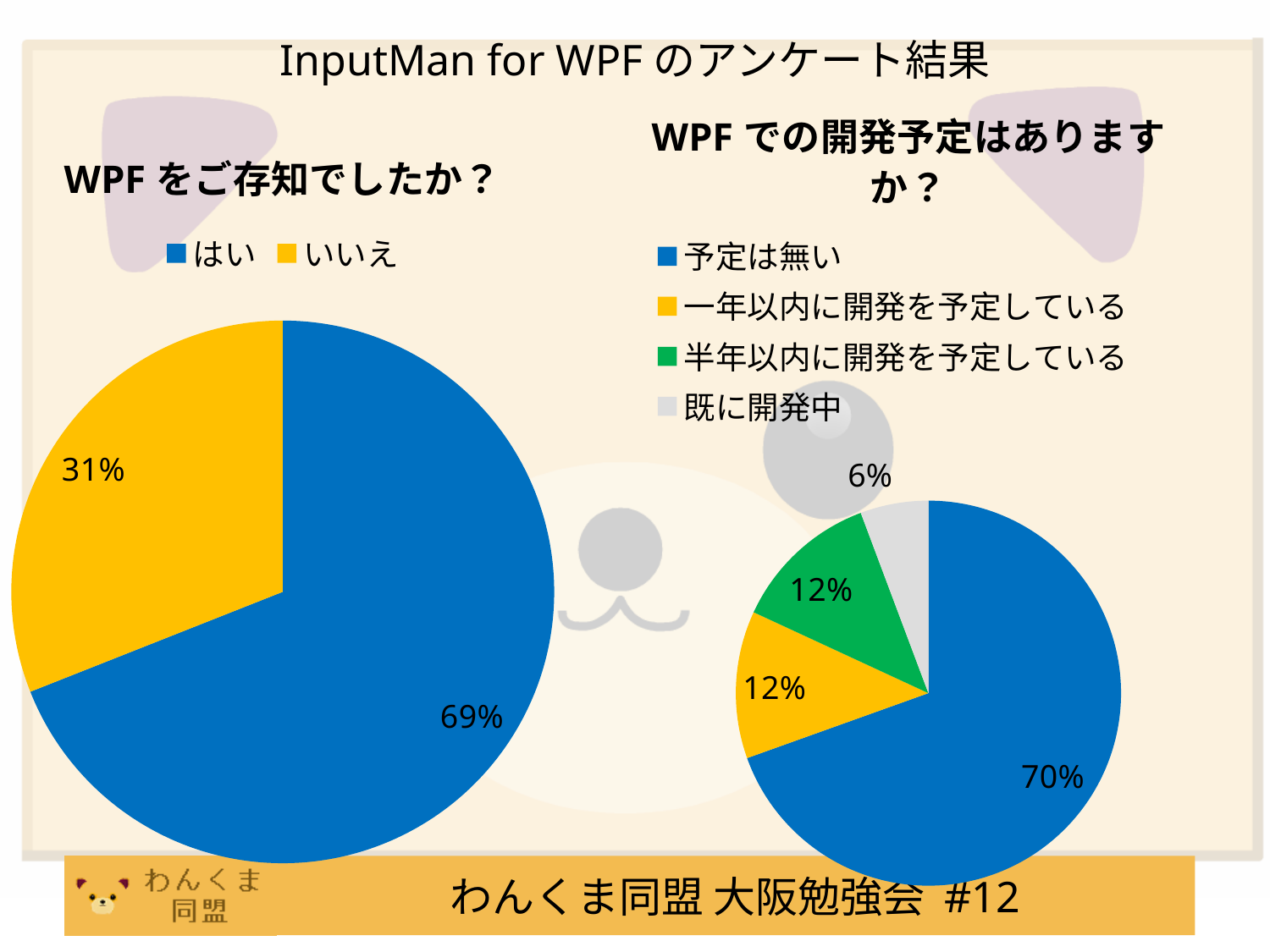
In the chart titled 'WPF での開発予定はありますか？', what share of respondents chose 予定は無い? 70% In the chart titled 'WPF をご存知でしたか？', what share of respondents answered いいえ? 31% How many categories does the legend of the chart titled 'WPF での開発予定はありますか？' list? 4 In the chart titled 'WPF をご存知でしたか？', what share of respondents answered はい? 69% What kind of chart is the one titled 'WPF をご存知でしたか？'? Pie chart In the chart titled 'WPF での開発予定はありますか？', which category has the smallest share? 既に開発中 In the chart titled 'WPF をご存知でしたか？', which answer has the larger share? はい In the chart titled 'WPF での開発予定はありますか？', what colour is the slice for 半年以内に開発を予定している? Green In the chart titled 'WPF での開発予定はありますか？', what share of respondents chose 既に開発中? 6% In the chart titled 'WPF での開発予定はありますか？', which is larger: the share for 予定は無い or the share for 既に開発中? 予定は無い In the chart titled 'WPF での開発予定はありますか？', what share of respondents chose 一年以内に開発を予定している? 12% In the chart titled 'WPF をご存知でしたか？', what is the difference in percentage points between はい and いいえ? 38